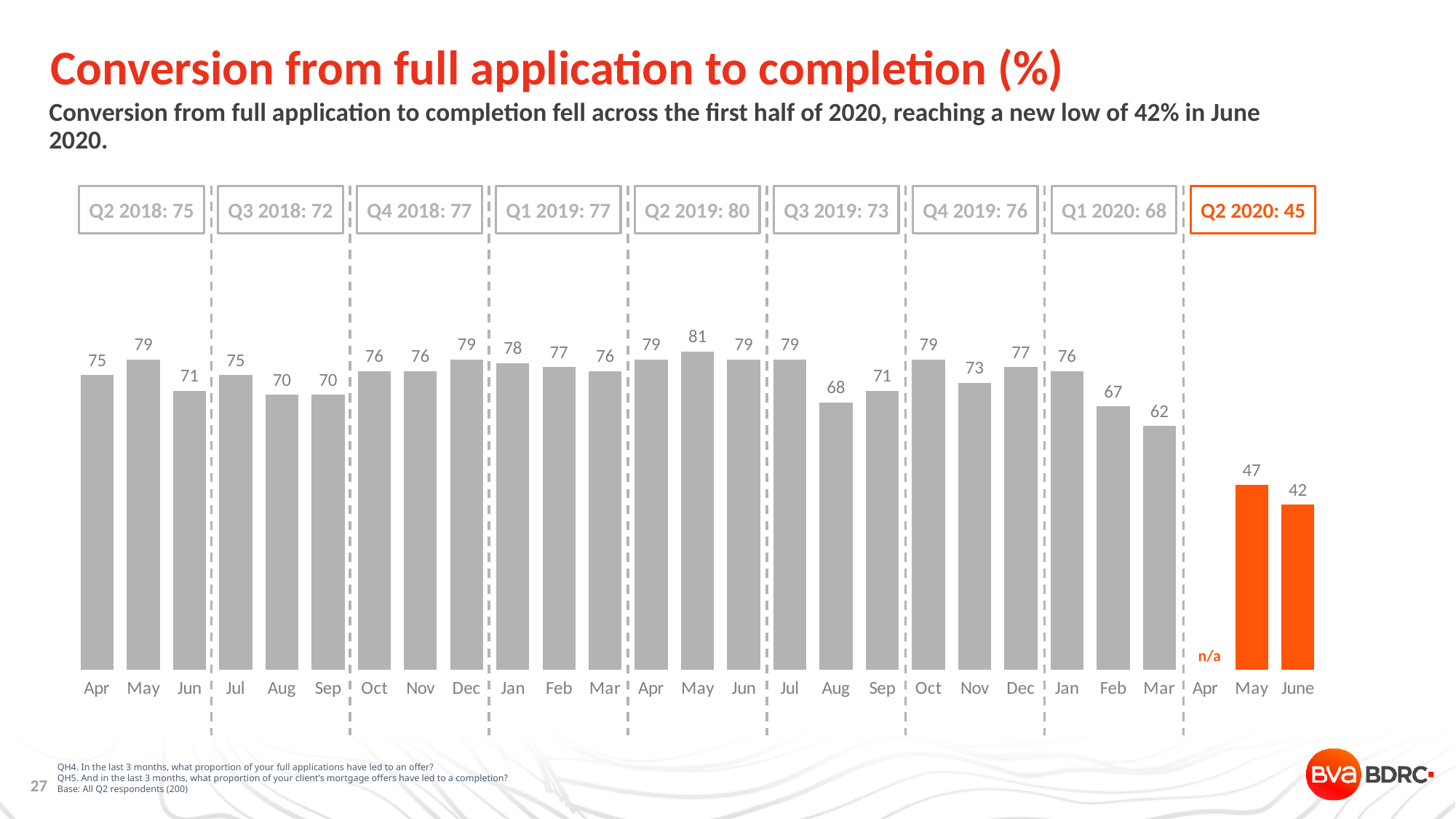
What is the value for June 2020 (in the Q2 2020 section)? 42 What kind of chart is shown on the slide? Bar chart Do the values rise or fall from Jan 2020 to June 2020? Fall Which month has the highest bar on the chart? May 2019 What is the value for Mar 2020 (in the Q1 2020 section)? 62 What is the difference between the values for May 2020 and June 2020? 5 Which month has the lowest bar on the chart? June 2020 What is the value for May 2019 (in the Q2 2019 section)? 81 What is the quarterly figure shown in the box for Q2 2020? 45 What value is shown for Apr 2020? n/a What is the difference between the values for Feb 2020 and Mar 2020? 5 Which is larger, the value for Aug 2019 or the value for Sep 2019? Sep 2019